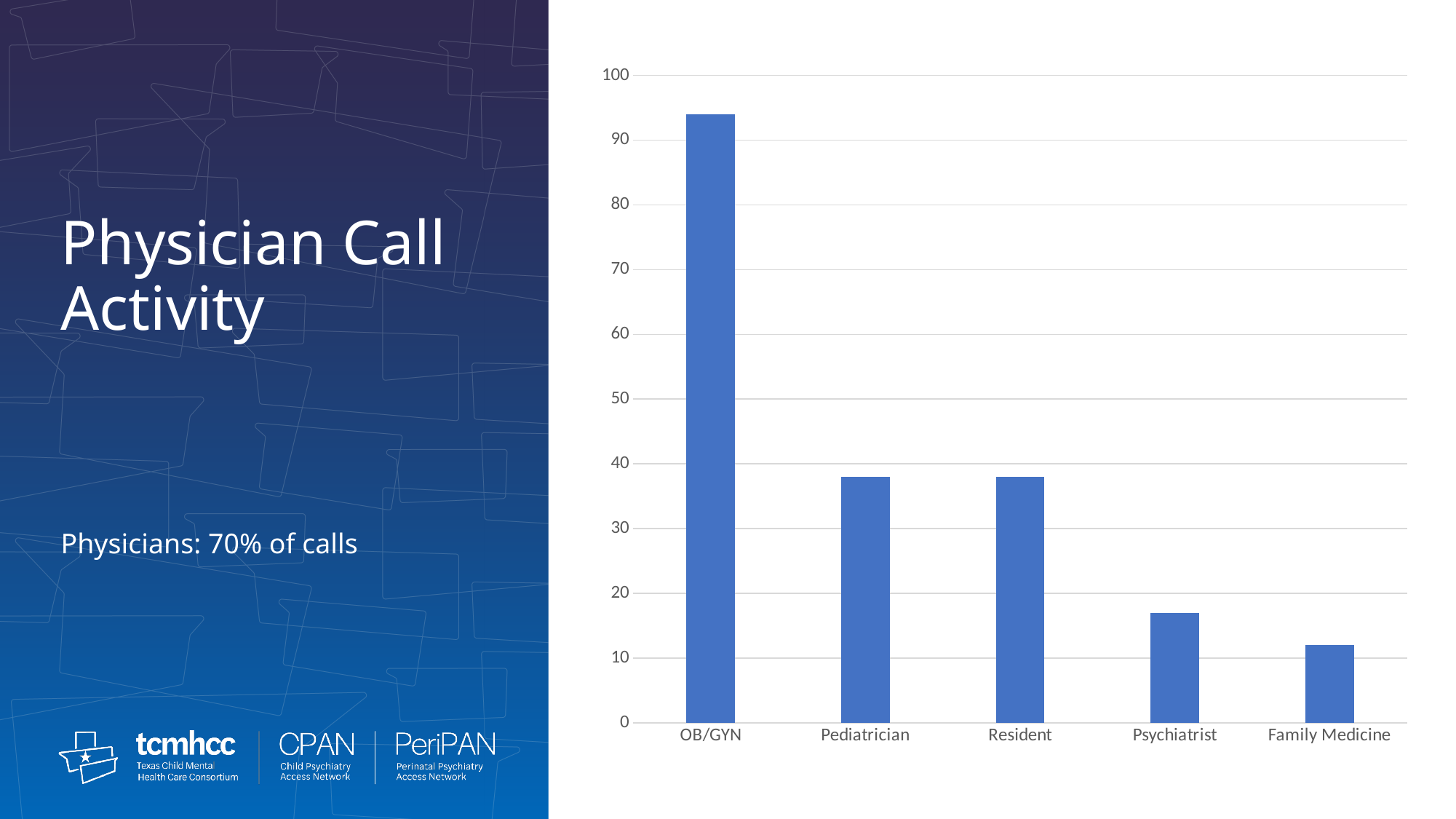
Which category has the lowest bar in the chart? Family Medicine Is the value for OB/GYN greater or less than 90? greater What kind of chart is shown on the slide? bar chart Which is larger, the value for Psychiatrist or the value for Family Medicine? Psychiatrist Which is larger, the value for OB/GYN or the value for Resident? OB/GYN Is the value for Resident greater or less than 30? greater How many categories are shown on the x axis of the chart? 5 Is the value for Family Medicine greater or less than 10? greater What is the highest tick value shown on the y axis of the chart? 100 Which category has the highest bar in the chart? OB/GYN